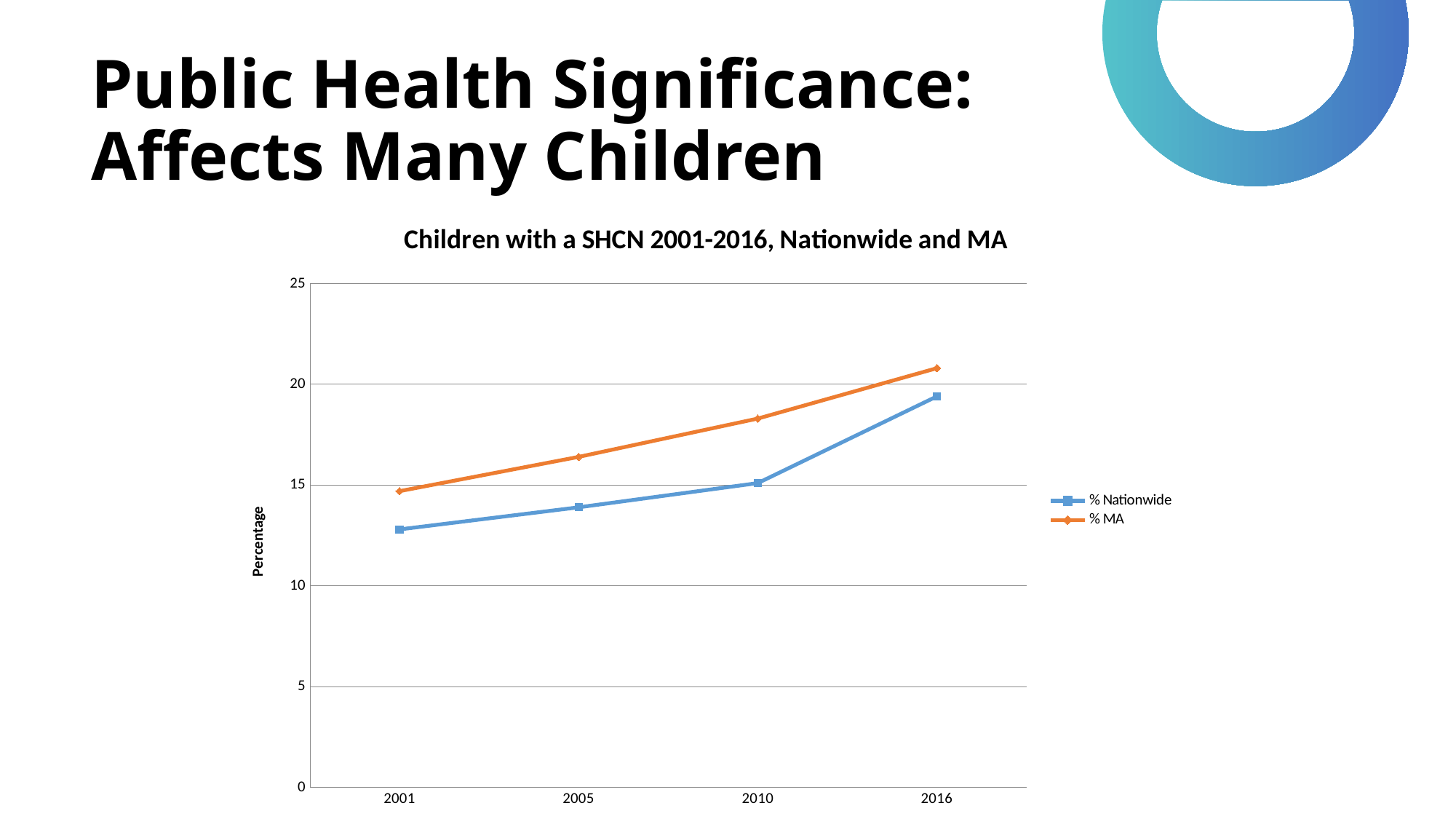
What type of chart is shown on the slide? line chart What is the title of the chart? Children with a SHCN 2001-2016, Nationwide and MA What is the label on the y axis? Percentage In which year is the % Nationwide value lowest? 2001 Is the % MA value for 2010 greater or less than 15? greater In which year is the % MA value highest? 2016 Is the % MA value for 2016 greater or less than 20? greater Which series has the higher value in 2016, % Nationwide or % MA? % MA Is the % Nationwide value for 2001 greater or less than 15? less How many series does the legend list? 2 Do the % Nationwide values rise or fall from 2001 to 2016? rise How many years are plotted along the x axis? 4